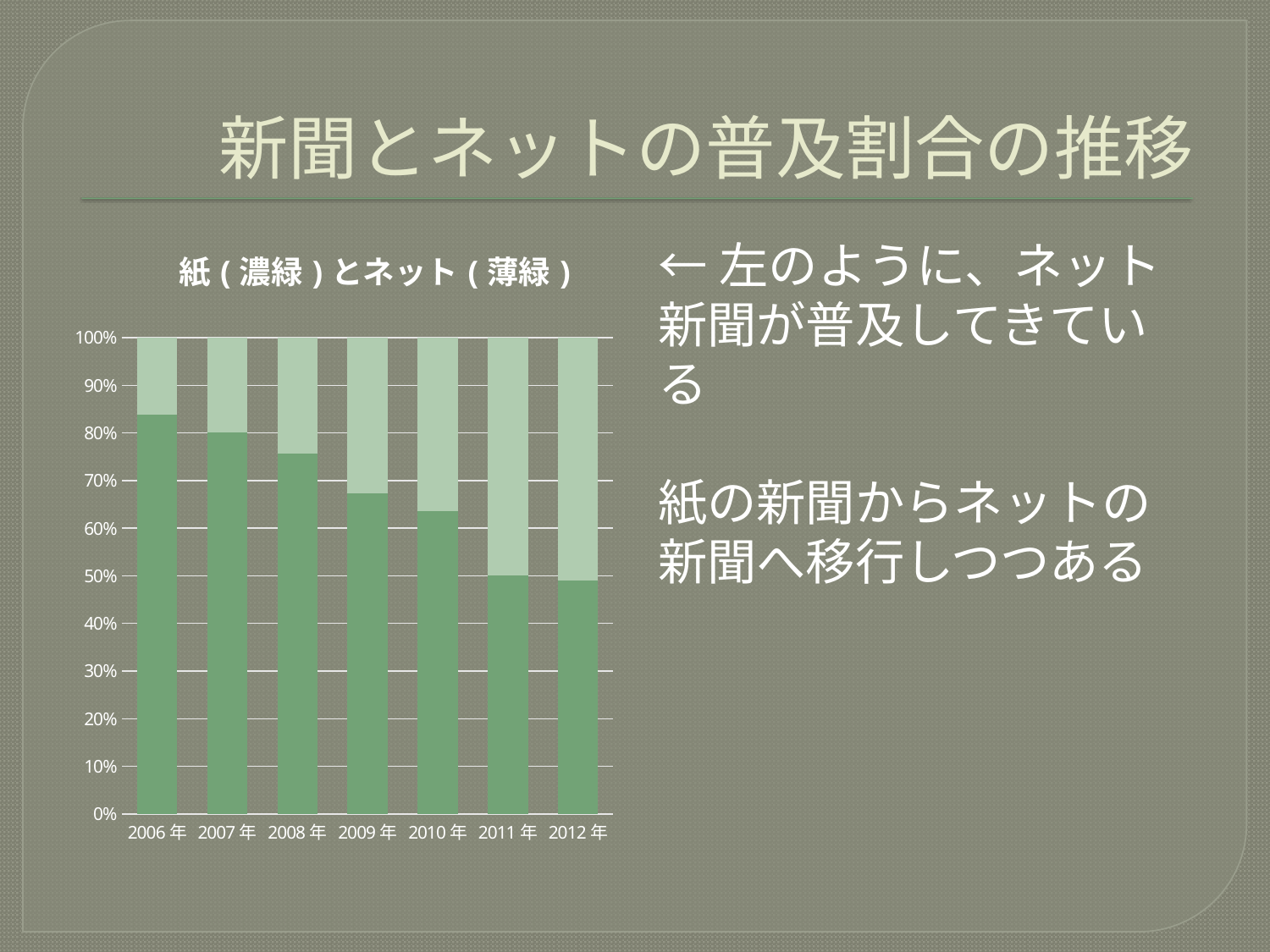
In which year is the light green (ネット) share the lowest? 2006年 In which year is the dark green (紙) share the highest? 2006年 Is the dark green (紙) share for 2008年 greater or less than 70%? greater What is the title of the chart? 紙(濃緑)とネット(薄緑) Which year has a larger dark green (紙) share, 2006年 or 2010年? 2006年 What kind of chart is shown on the slide? Stacked bar chart What is the total of the stacked bar for 2006年? 100% Which colour represents 紙 (paper newspapers) in the chart? Dark green Is the dark green (紙) share for 2006年 greater or less than 80%? greater How many years are shown on the x axis of the chart? 7 Does the dark green (紙) share rise or fall from 2006年 to 2012年? Fall Is the dark green (紙) share for 2010年 greater or less than 70%? less